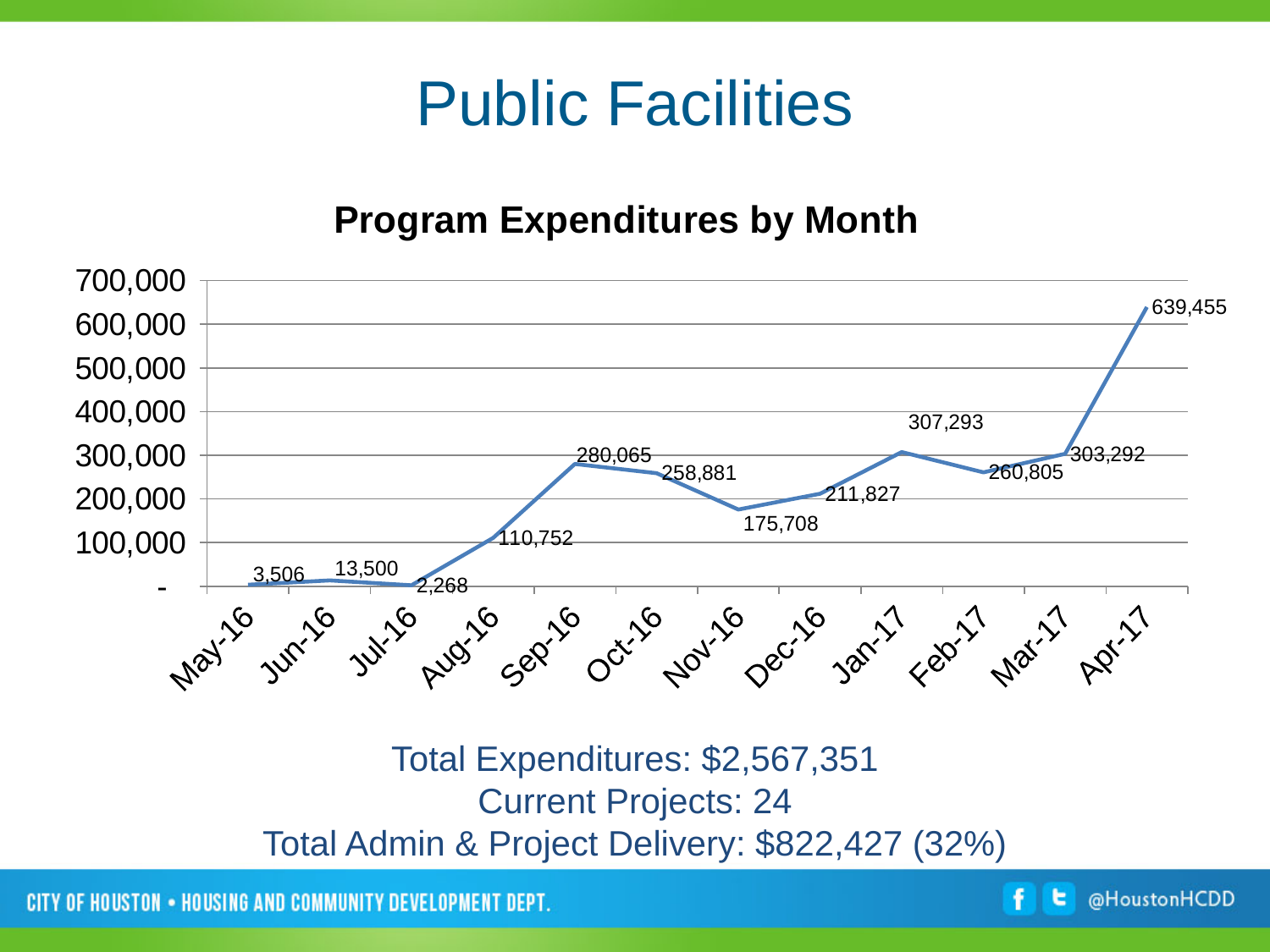
What is the title of the chart? Program Expenditures by Month What is the difference between the values for Apr-17 and Mar-17? 336,163 Which month has the highest expenditure? Apr-17 What is the difference between the values for Sep-16 and Aug-16? 169,313 Which month has the lowest expenditure? Jul-16 What is the value for Nov-16? 175,708 What is the value for Apr-17? 639,455 Which is larger, the value for Sep-16 or the value for Oct-16? Sep-16 What is the value for Aug-16? 110,752 Is the value for Jan-17 greater or less than 400,000? less What type of chart is shown on the slide? Line chart How many months are plotted on the chart? 12